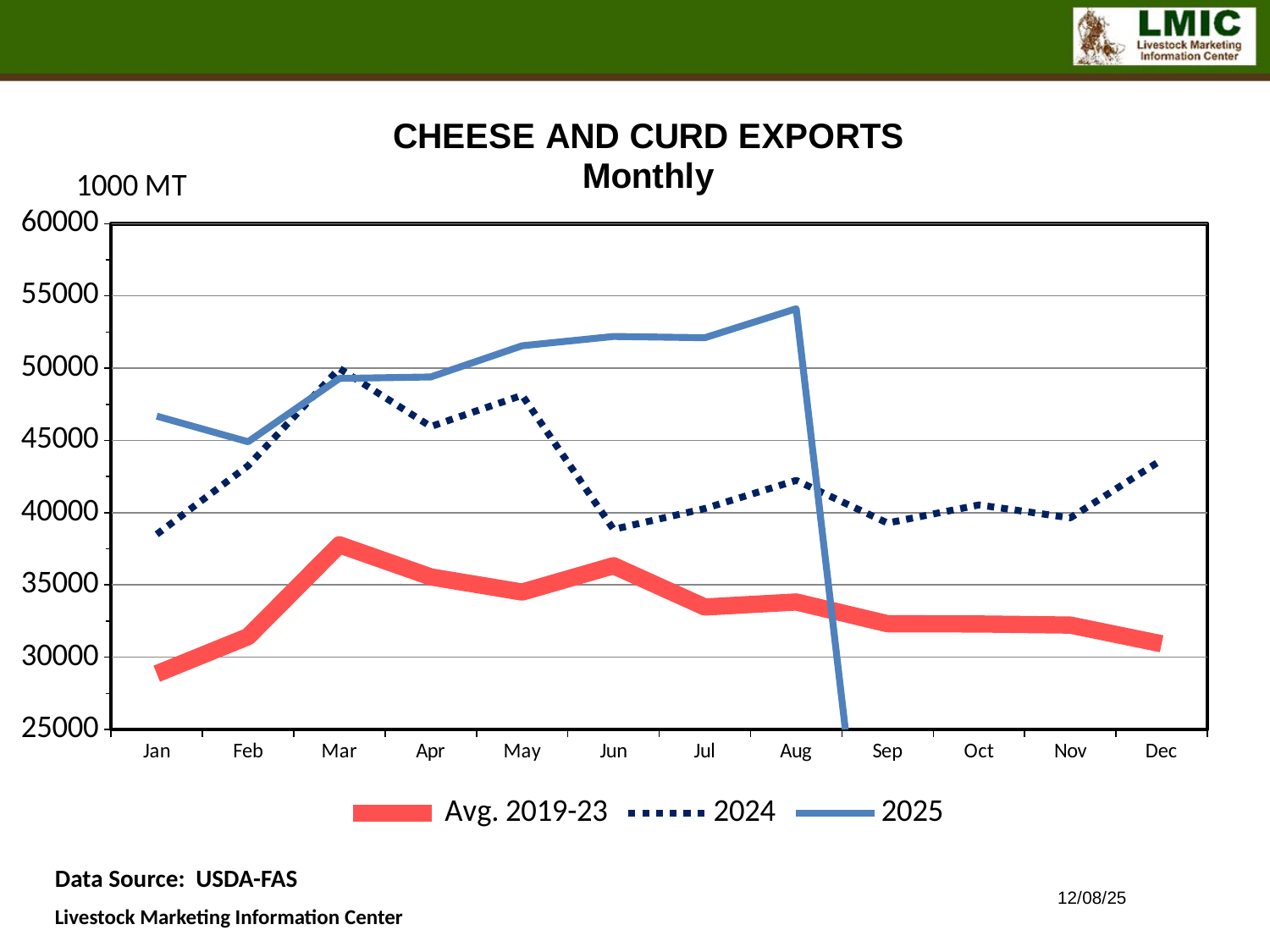
Is the 2024 value for Dec greater or less than 40000? greater How many series does the legend list? 3 In which month does the 2025 series reach its highest value? Aug In which month is the Avg. 2019-23 series at its highest? Mar Is the 2025 value for Aug greater or less than 50000? greater In May, which series is larger: 2025 or 2024? 2025 What kind of chart is shown on the slide? line chart Is the Avg. 2019-23 value for Jan greater or less than 30000? less Does the 2025 series rise or fall from Feb to Aug? rise What unit is shown on the y axis of the chart? 1000 MT How many months are shown along the x axis? 12